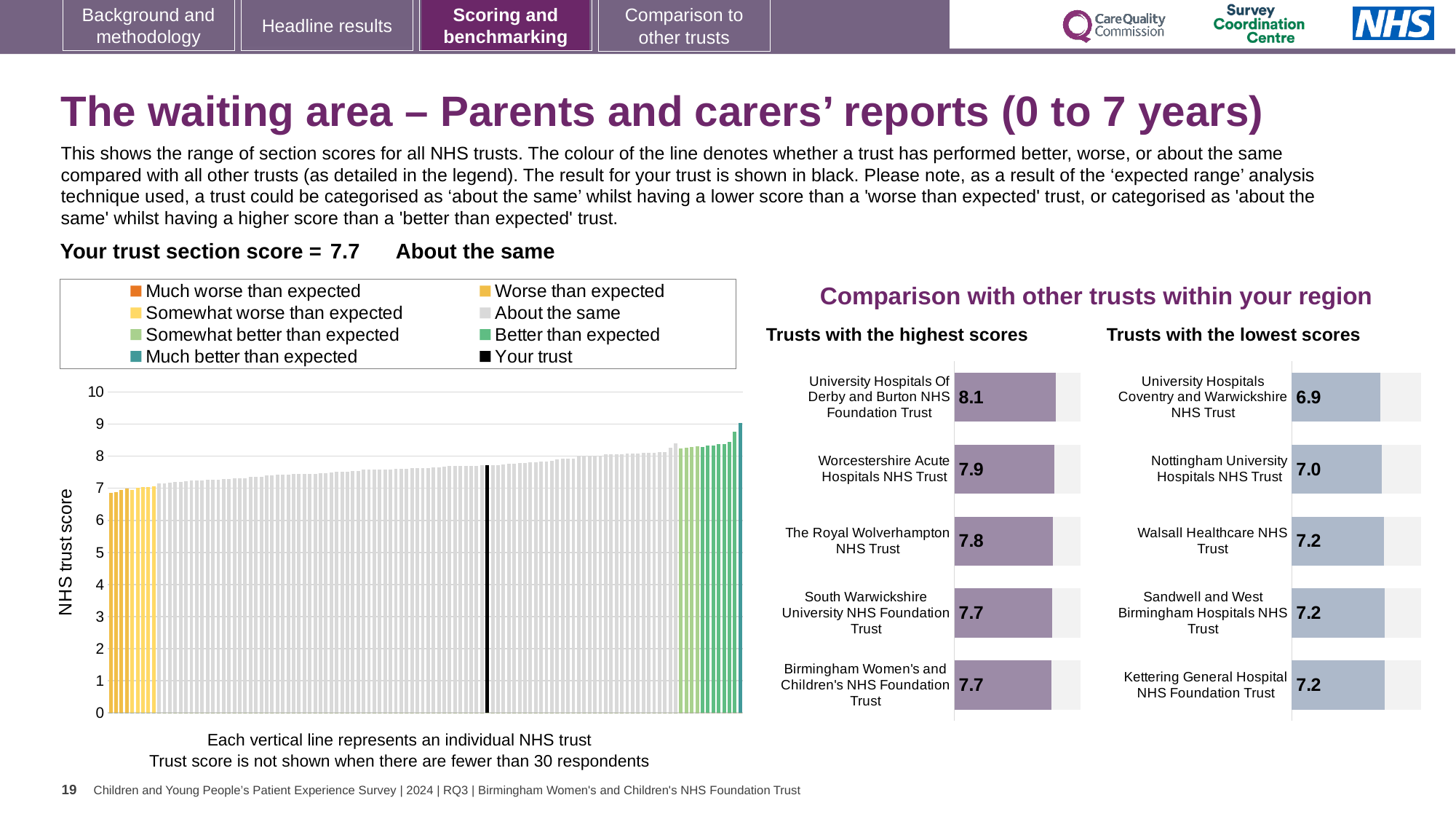
In the large chart on the left, is the value for the black 'Your trust' bar greater or less than 7? greater In the 'Trusts with the highest scores' chart, which trust has the highest score? University Hospitals Of Derby and Burton NHS Foundation Trust What is the label of the vertical axis on the large chart on the left? NHS trust score In the 'Trusts with the highest scores' chart, what is the score for Worcestershire Acute Hospitals NHS Trust? 7.9 How many trusts are shown in the 'Trusts with the highest scores' chart? 5 In the 'Trusts with the lowest scores' chart, which trust has the lowest score? University Hospitals Coventry and Warwickshire NHS Trust How many entries does the legend above the large chart on the left list? 8 In the 'Trusts with the lowest scores' chart, what is the score for Nottingham University Hospitals NHS Trust? 7.0 In the 'Trusts with the lowest scores' chart, which has the larger score: Nottingham University Hospitals NHS Trust or Walsall Healthcare NHS Trust? Walsall Healthcare NHS Trust In the 'Trusts with the highest scores' chart, what is the difference between the scores of University Hospitals Of Derby and Burton NHS Foundation Trust and The Royal Wolverhampton NHS Trust? 0.3 What kind of chart is the large chart on the left with the 'NHS trust score' axis? Bar chart In the large chart on the left, do the bar values rise or fall from left to right? Rise